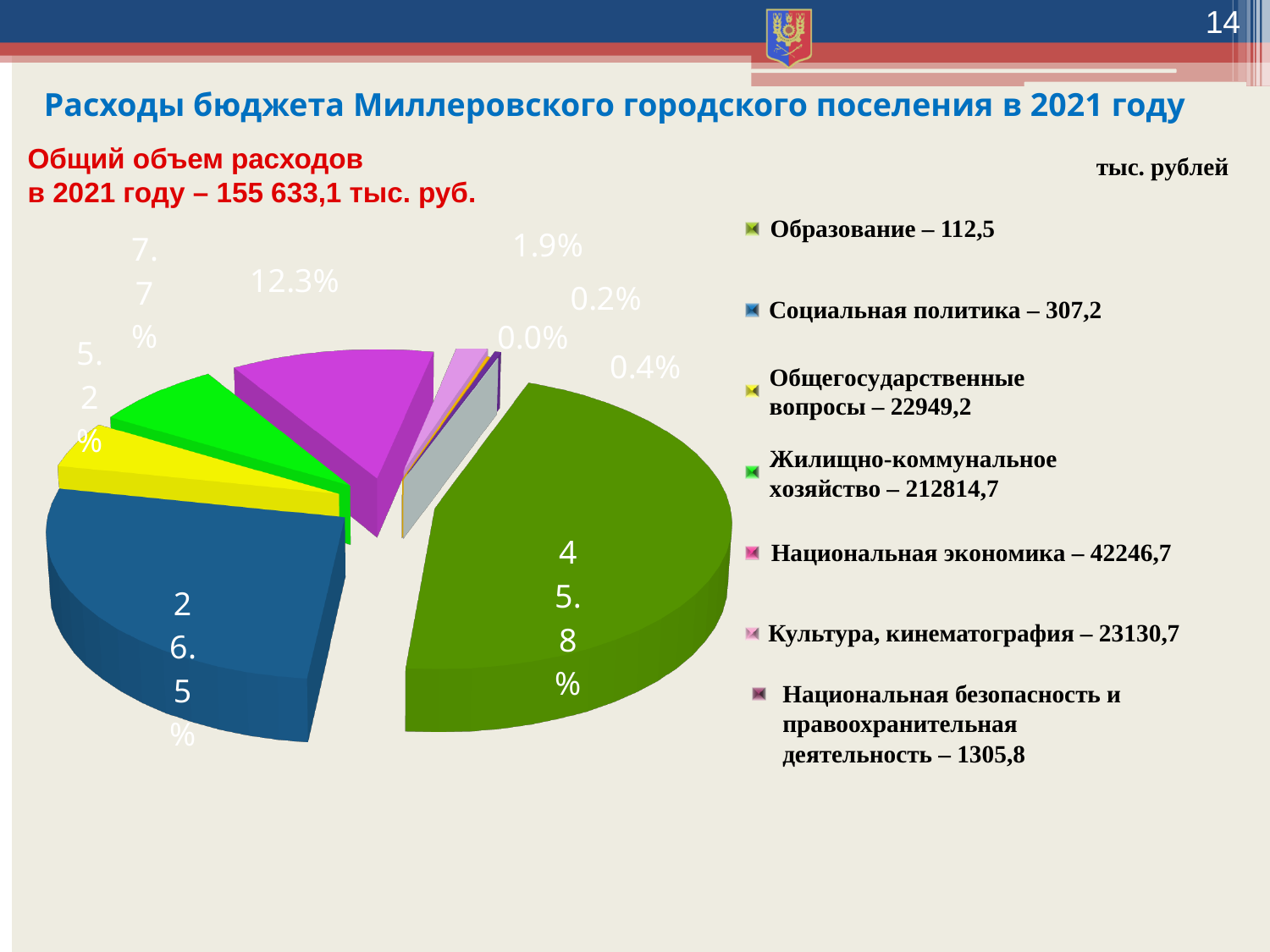
According to the legend, what is the value for Образование? 112,5 Which legend entry has the smallest value? Образование What kind of chart is shown on the slide? pie chart How many categories does the legend list? 7 What percentage is shown on the blue slice of the pie chart? 26.5% What unit is stated for the values in the legend? тыс. рублей What is the difference between the legend values for Культура, кинематография and Общегосударственные вопросы? 181,5 What percentage is shown on the largest slice of the pie chart? 45.8% Which legend entry has the largest value? Жилищно-коммунальное хозяйство According to the legend, what is the value for Национальная экономика? 42246,7 Which is larger according to the legend: Общегосударственные вопросы or Культура, кинематография? Культура, кинематография According to the legend, what is the value for Национальная безопасность и правоохранительная деятельность? 1305,8